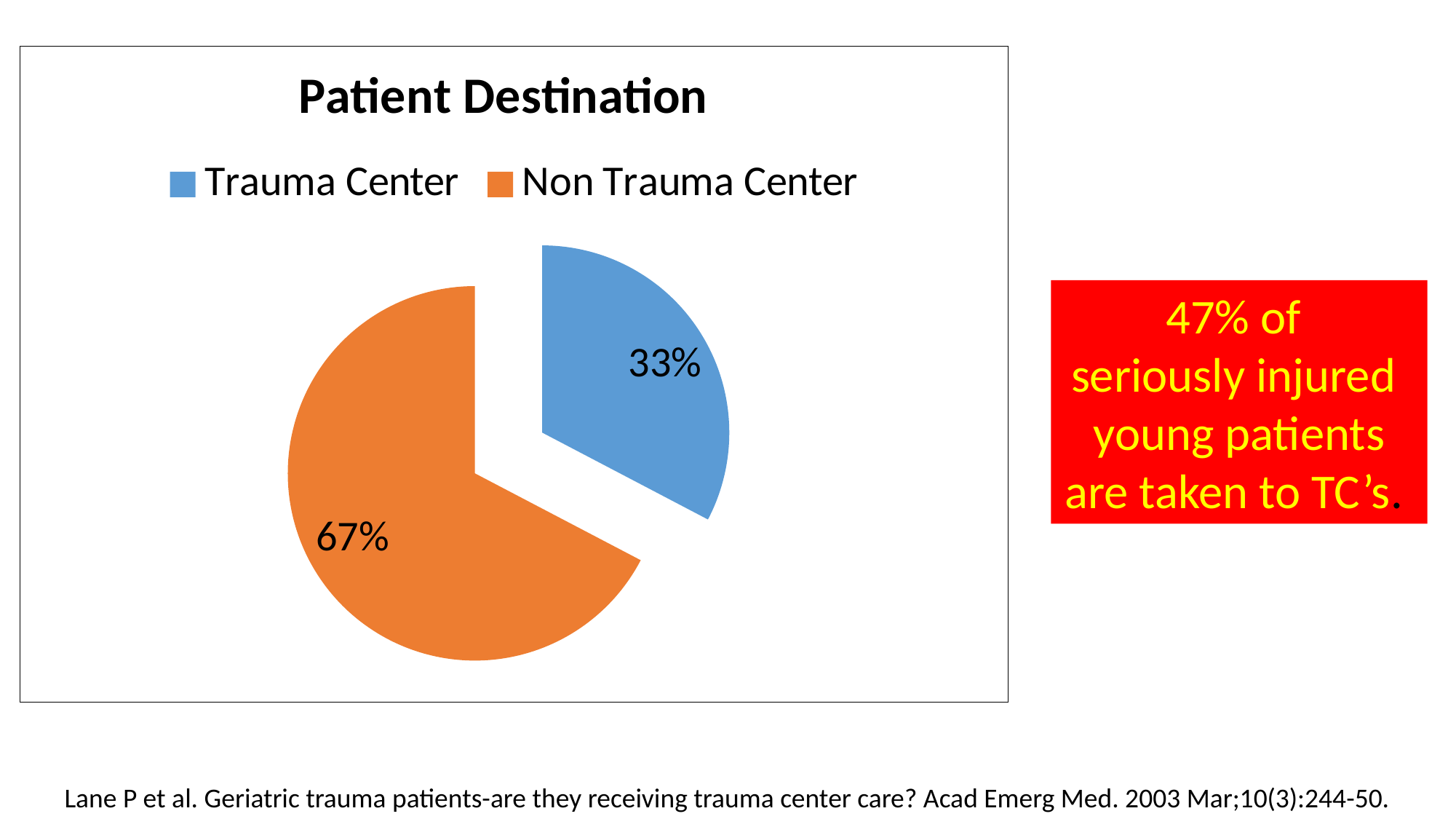
What is the difference in percentage points between the Non Trauma Center and Trauma Center slices? 34 What colour is the Trauma Center slice? blue What is the title of the chart? Patient Destination Which is larger, the Trauma Center slice or the Non Trauma Center slice? Non Trauma Center How many entries does the legend list? 2 What share of the pie is Trauma Center? 33% Which category has the largest slice of the pie? Non Trauma Center How many slices does the pie chart have? 2 What share of the pie is Non Trauma Center? 67% Is the Trauma Center share greater or less than 50%? less Which category has the smallest slice of the pie? Trauma Center What kind of chart is shown on the slide? pie chart